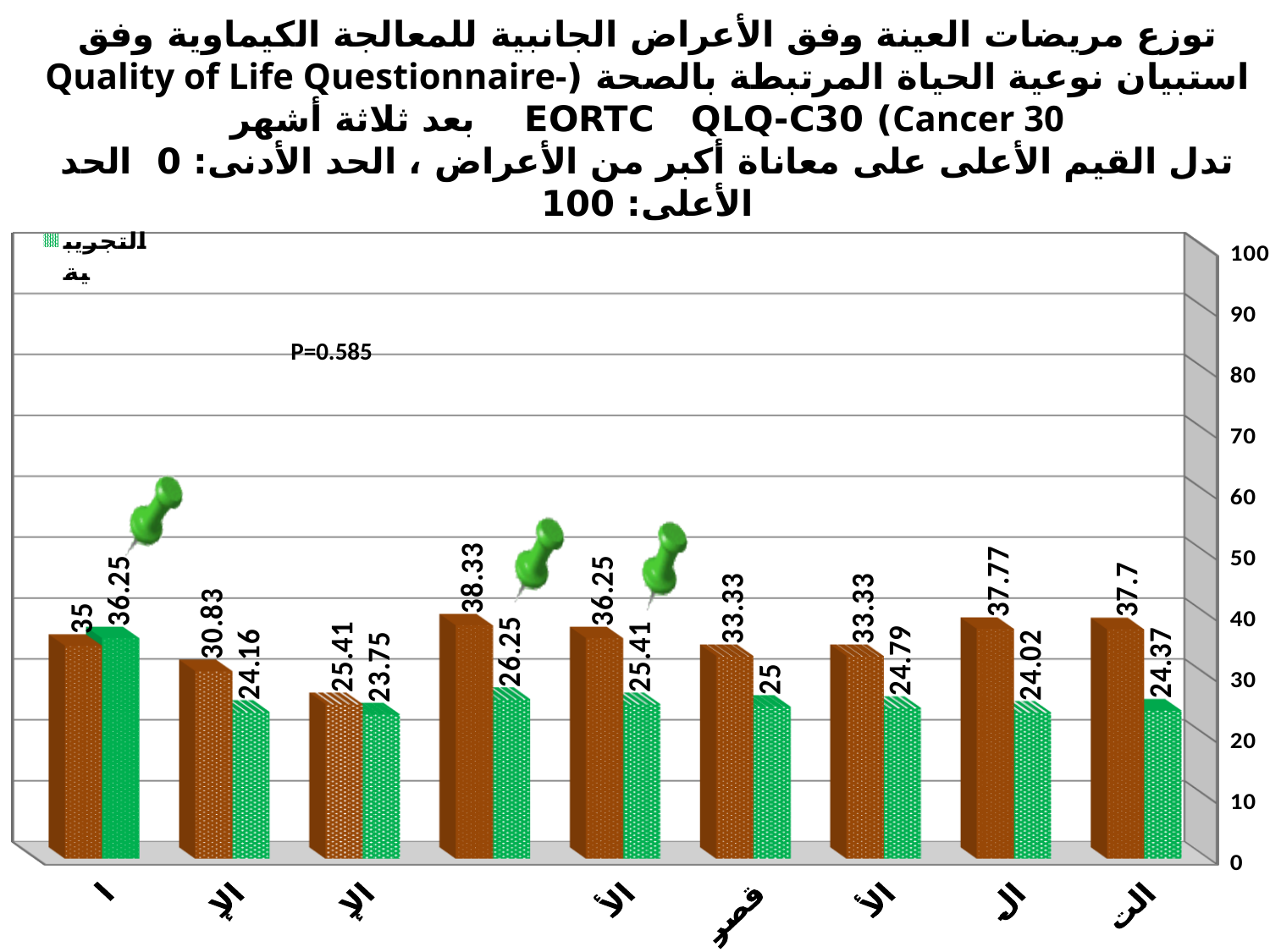
How many category groups are plotted along the x axis? 9 In the fourth group from the left, what is the difference between the brown bar (38.33) and the green bar (26.25)? 12.08 What is the lowest value among the green bars? 23.75 What is the value of the green bar in the rightmost group? 24.37 Is the value of the tallest bar on the chart greater or less than 40? less What P value is printed on the chart? P=0.585 What is the value of the brown bar in the leftmost group? 35 What is the lowest value among the brown bars? 25.41 What is the highest value among the green bars? 36.25 What kind of chart is shown on the slide? bar chart In the leftmost group, which bar is larger, the brown one or the green one? green What is the highest value among the brown bars? 38.33